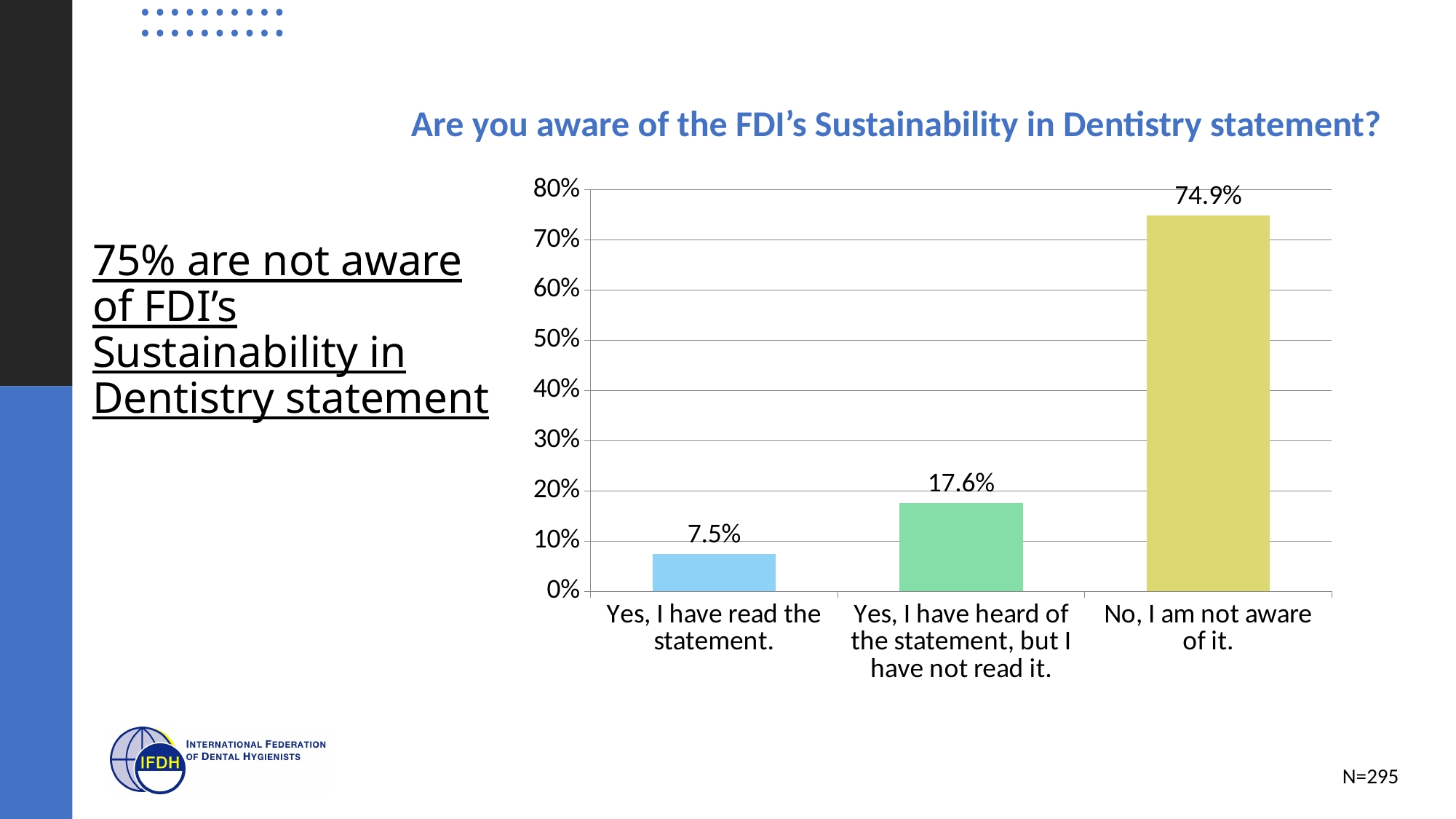
Which response category has the highest percentage? No, I am not aware of it. How many response categories are shown on the x axis? 3 What is the difference in percentage points between "Yes, I have heard of the statement, but I have not read it." and "Yes, I have read the statement."? 10.1 percentage points Is the value for "No, I am not aware of it." greater or less than 70%? greater What percentage of respondents answered "Yes, I have heard of the statement, but I have not read it."? 17.6% What percentage of respondents answered "Yes, I have read the statement."? 7.5% What is the difference in percentage points between "No, I am not aware of it." and "Yes, I have heard of the statement, but I have not read it."? 57.3 percentage points What is the title of the chart? Are you aware of the FDI's Sustainability in Dentistry statement? Which response category has the lowest percentage? Yes, I have read the statement. What kind of chart is shown on the slide? Bar chart What percentage of respondents answered "No, I am not aware of it."? 74.9% Which is larger: the percentage for "Yes, I have read the statement." or for "Yes, I have heard of the statement, but I have not read it."? Yes, I have heard of the statement, but I have not read it.